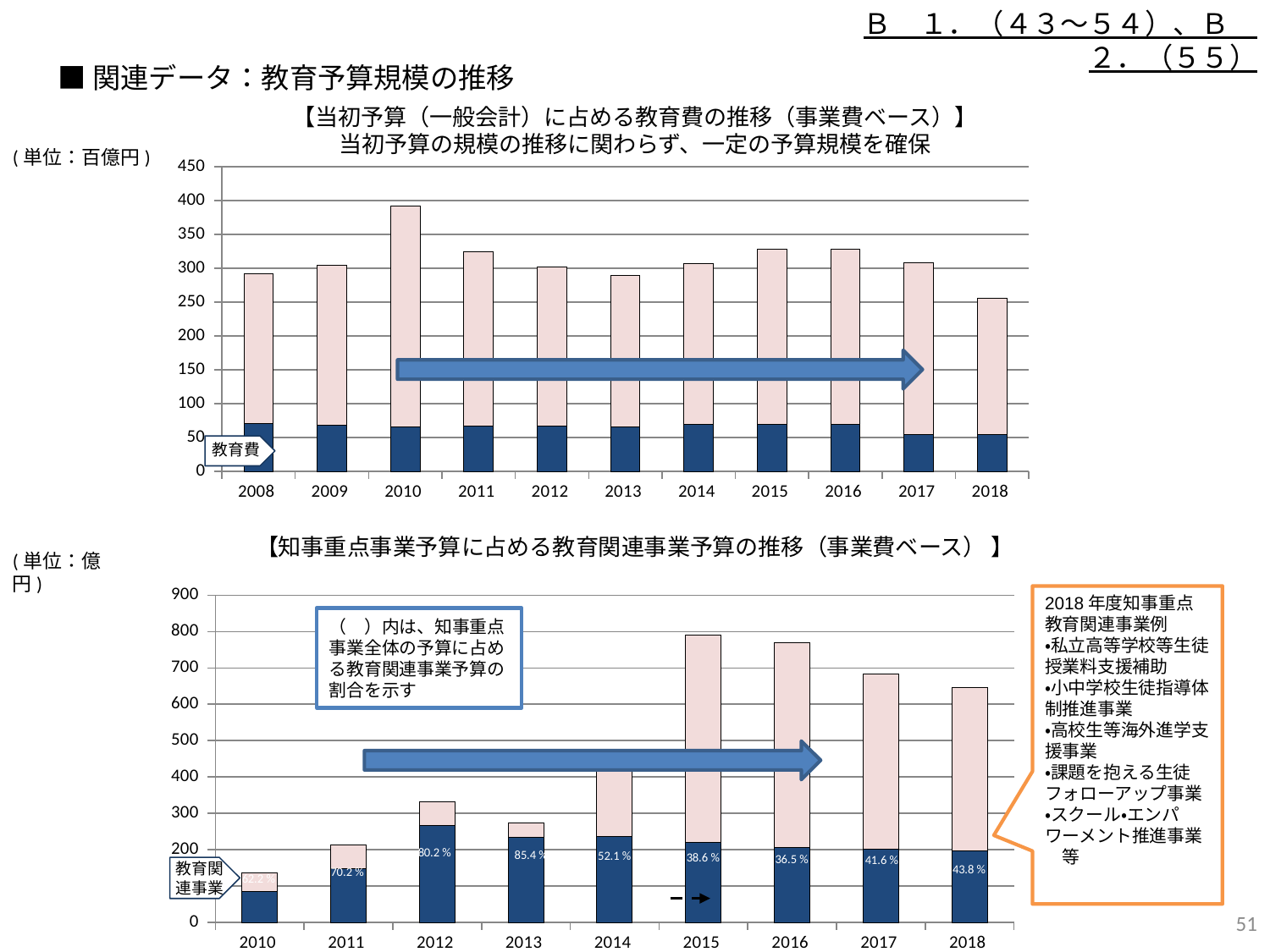
What kind of chart is the top chart, 当初予算（一般会計）に占める教育費の推移? bar chart In the bottom chart (知事重点事業予算に占める教育関連事業予算の推移), which year has the highest labelled percentage? 2013 In the top chart (当初予算に占める教育費の推移), which year has the tallest total bar? 2010 In the bottom chart (知事重点事業予算に占める教育関連事業予算の推移), what percentage is labelled on the 2016 bar? 36.5% In the top chart (当初予算に占める教育費の推移), is the total bar for 2010 greater or less than 350? greater In the bottom chart (知事重点事業予算に占める教育関連事業予算の推移), which year has the larger labelled percentage, 2017 or 2018? 2018 In the bottom chart (知事重点事業予算に占める教育関連事業予算の推移), how many years are shown on the x axis? 9 In the top chart (当初予算に占める教育費の推移), is the total bar for 2018 greater or less than 300? less In the bottom chart (知事重点事業予算に占める教育関連事業予算の推移), which year has the tallest total bar? 2015 In the bottom chart (知事重点事業予算に占める教育関連事業予算の推移), what percentage is labelled on the 2013 bar? 85.4% In the top chart (当初予算に占める教育費の推移), which year has the shortest total bar? 2018 In the top chart (当初予算に占める教育費の推移), how many years are shown on the x axis? 11